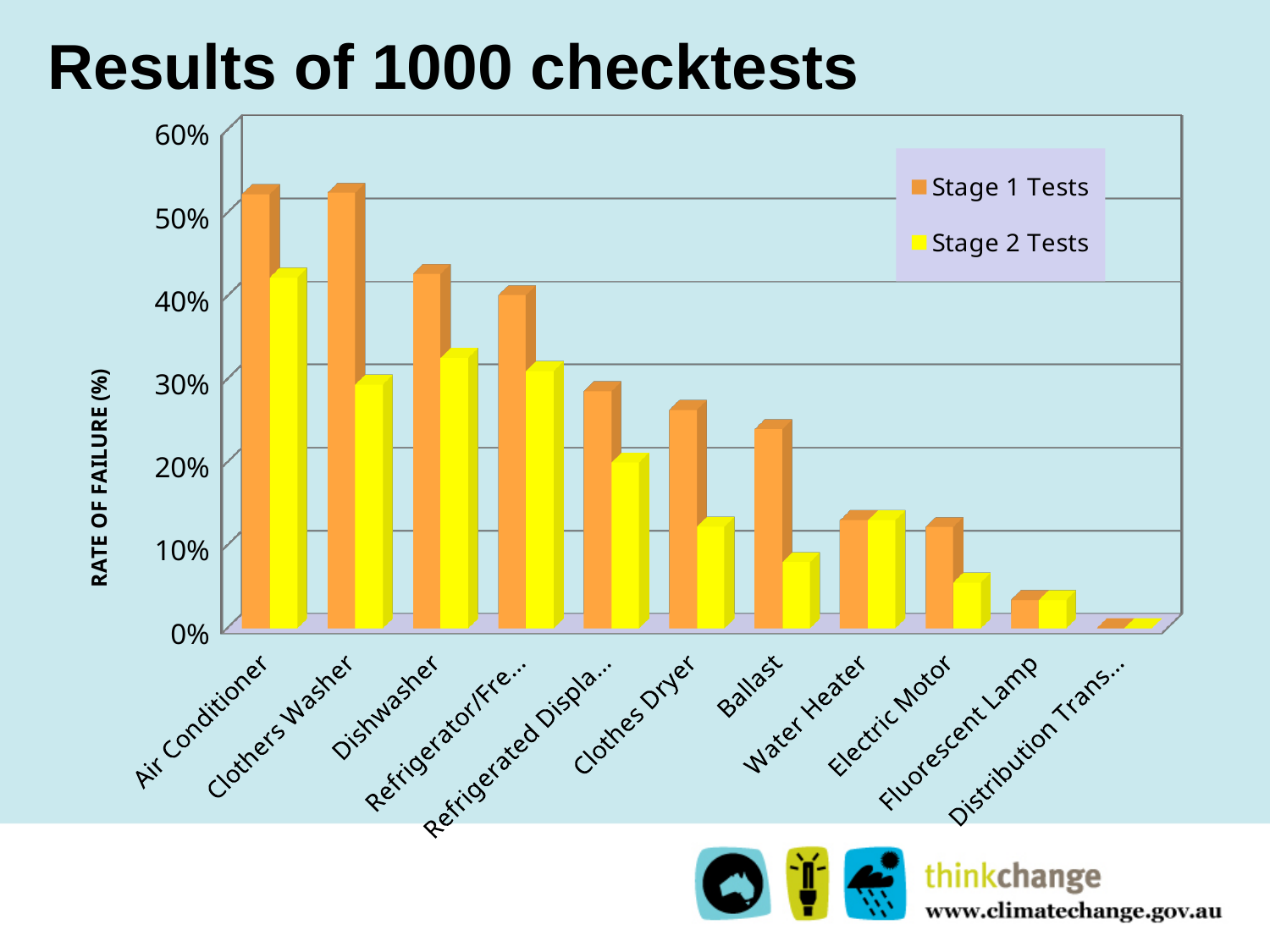
What is the label of the y axis? RATE OF FAILURE (%) Is the Stage 1 Tests value for Clothes Dryer greater or less than 30%? less What kind of chart is shown on the slide? bar chart Is the Stage 2 Tests value for Ballast greater or less than 20%? less Do the Stage 1 Tests values generally rise or fall from left to right along the x axis? fall Is the Stage 1 Tests value for Fluorescent Lamp greater or less than 10%? less How many product categories are shown on the x axis? 11 For Clothes Dryer, which is larger: the Stage 1 Tests value or the Stage 2 Tests value? Stage 1 Tests Which category has the highest Stage 2 Tests failure rate? Air Conditioner Which category has the lowest Stage 1 Tests failure rate? Distribution Trans... How many series does the legend list? 2